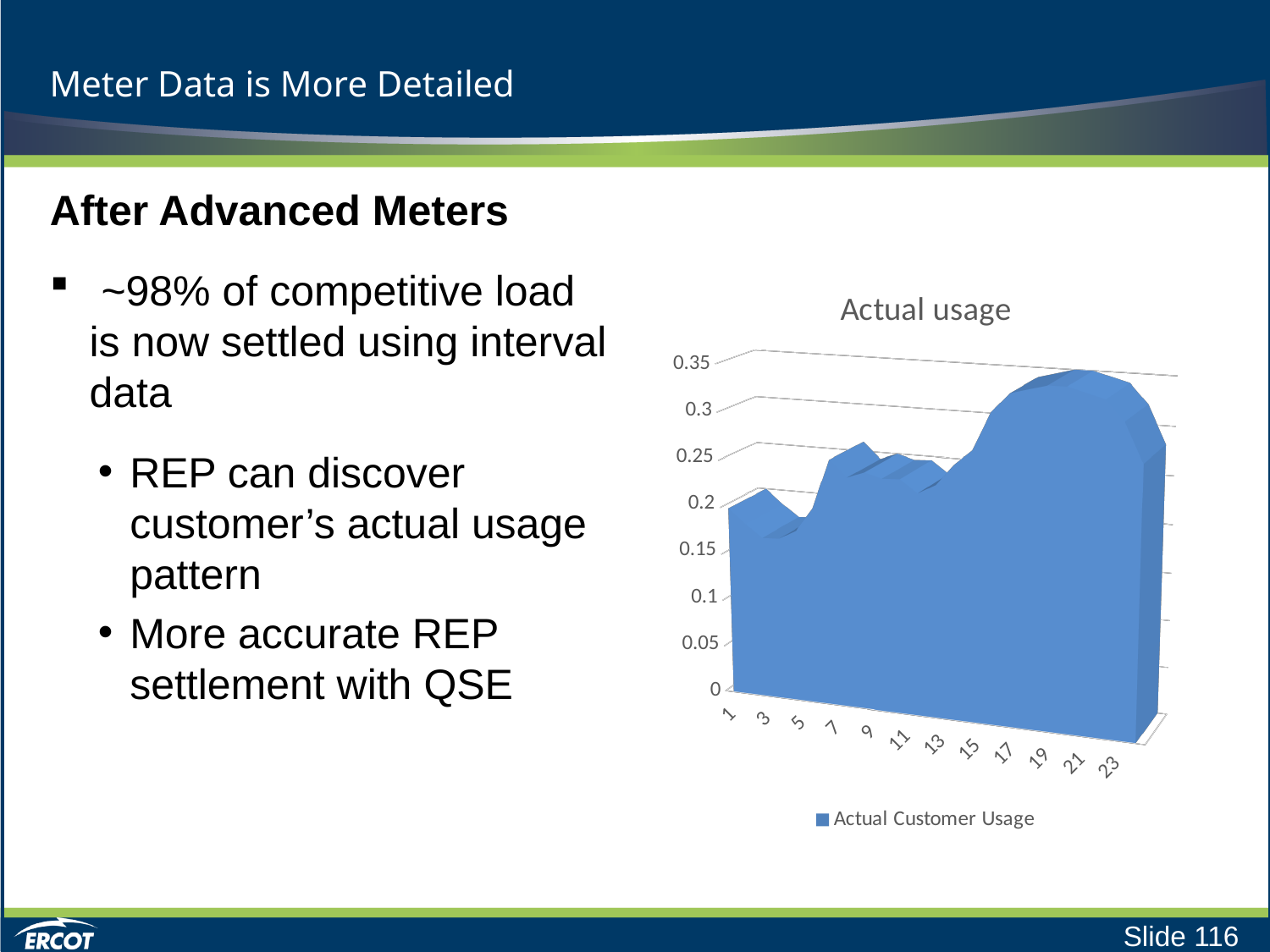
What series name does the chart legend list? Actual Customer Usage Is the value for Actual Customer Usage at 5 greater or less than 0.25? less Which is larger, the value for Actual Customer Usage at 21 or at 5? 21 Is the value for Actual Customer Usage at 1 greater or less than 0.3? less What kind of chart is shown on the slide? Area chart Does Actual Customer Usage rise or fall between 15 and 21 on the x axis? rise Does Actual Customer Usage rise or fall between 21 and 23 on the x axis? fall Is the value for Actual Customer Usage at 21 greater or less than 0.25? greater How many series does the chart legend list? 1 What is the title of the chart on the slide? Actual usage